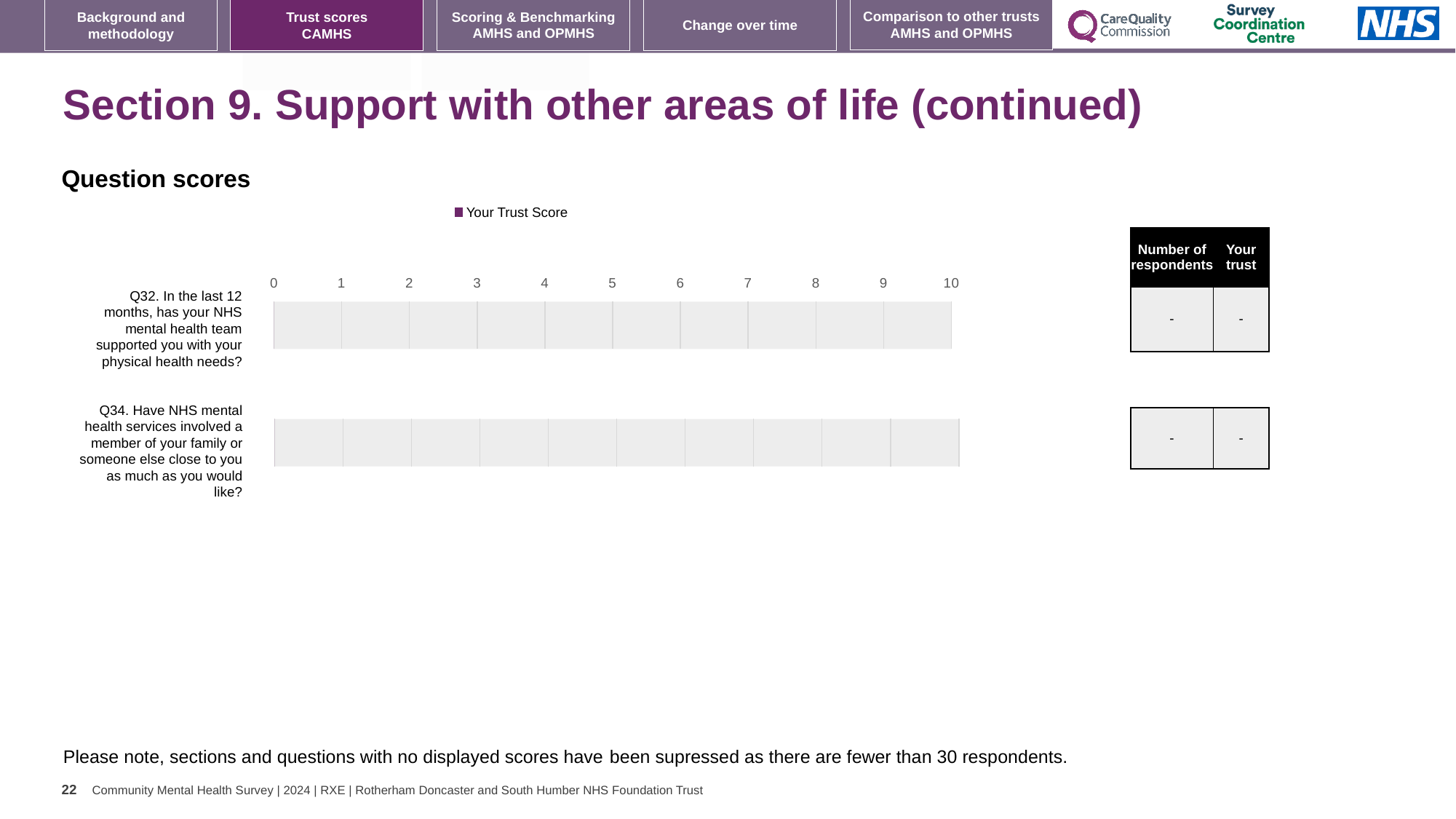
What is the name of the series shown in the chart legend? Your Trust Score Which question label appears first (at the top) on the chart's vertical axis? Q32. In the last 12 months, has your NHS mental health team supported you with your physical health needs? What is the highest value shown on the chart's horizontal axis? 10 What is shown in the 'Your trust' column of the table for Q32? - How many questions (categories) are listed on the chart's vertical axis? 2 How many series does the chart legend list? 1 What is shown in the 'Number of respondents' column of the table for Q34? - What kind of chart is shown under 'Question scores'? bar chart